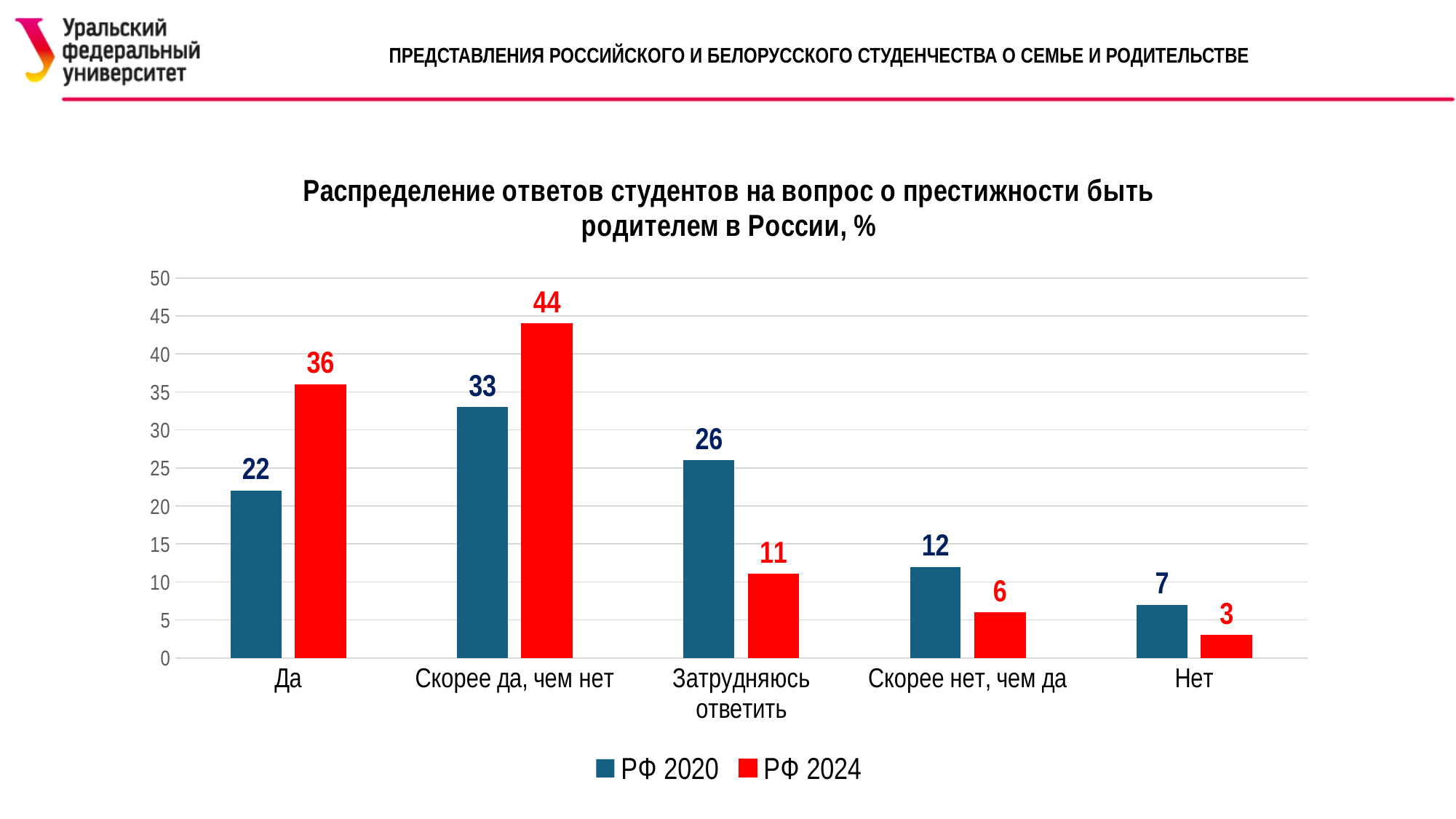
Is the РФ 2024 value for "Да" greater or less than 30? greater What is the value for "Да" in the РФ 2024 series? 36 Which is larger for "Скорее нет, чем да": the РФ 2020 value or the РФ 2024 value? РФ 2020 What is the value for "Нет" in the РФ 2024 series? 3 What is the difference between the РФ 2020 and РФ 2024 values for "Затрудняюсь ответить"? 15 What is the difference between the РФ 2024 and РФ 2020 values for "Скорее да, чем нет"? 11 What is the value for "Затрудняюсь ответить" in the РФ 2020 series? 26 Which category has the highest value in the РФ 2024 series? Скорее да, чем нет Which category has the lowest value in the РФ 2020 series? Нет How many categories are shown on the x axis? 5 What kind of chart is shown on the slide? Bar chart How many series does the legend list? 2